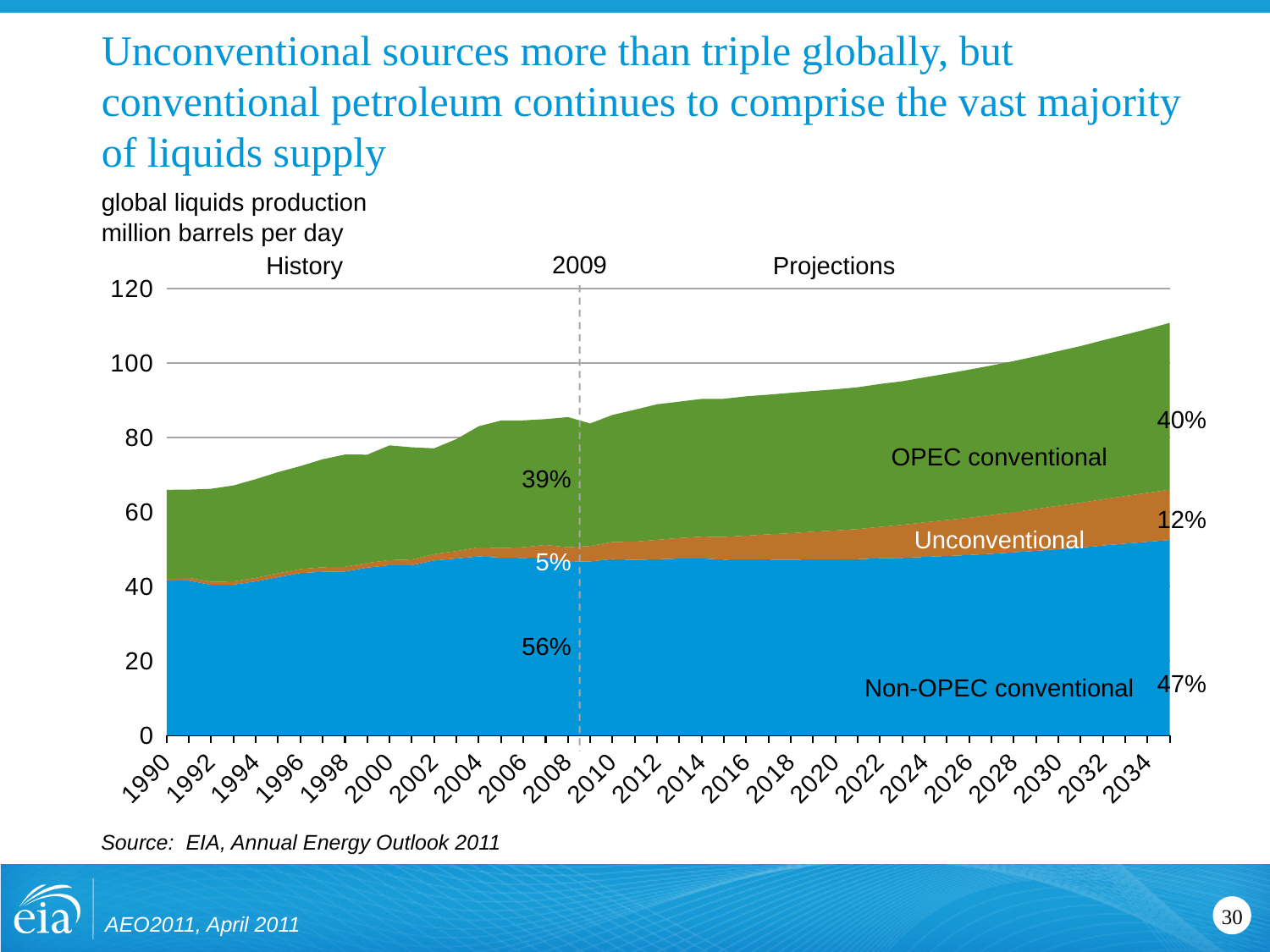
What share of global liquids production is OPEC conventional projected to reach at the end of the projection period? 40% What share of global liquids production did OPEC conventional account for in 2009? 39% What kind of chart is shown on the slide? stacked area chart What share of global liquids production did Unconventional sources account for in 2009? 5% Is total global liquids production in 1990 greater or less than 80 million barrels per day? less What share of global liquids production is Unconventional projected to reach at the end of the projection period? 12% What share of global liquids production did Non-OPEC conventional account for in 2009? 56% In 2009, which had the larger share of global liquids production, OPEC conventional or Non-OPEC conventional? Non-OPEC conventional In what unit is global liquids production measured in the chart? million barrels per day Does total global liquids production rise or fall over the projection period? rise By how many percentage points does the Unconventional share change from 2009 to the end of the projection period? 7 percentage points How many series are plotted in the chart? 3